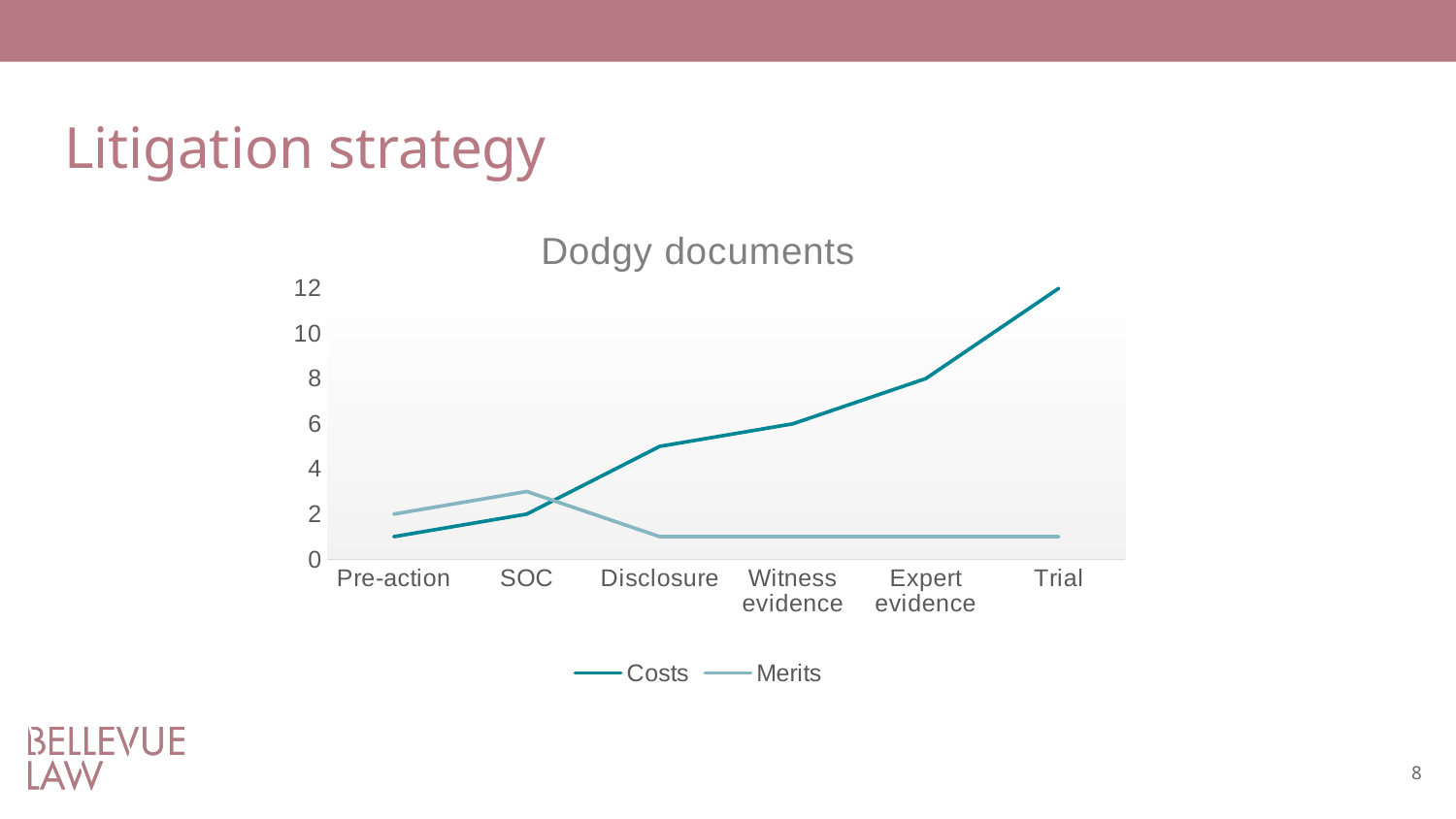
What kind of chart is shown on the slide? Line chart How many series does the legend list? 2 At which stage is the Costs series lowest? Pre-action Is the value of Costs at Disclosure greater or less than 4? greater What is the value of Merits at Pre-action? 2 What is the value of Costs at Trial? 12 At which stage is the Costs series highest? Trial What is the value of Costs at Expert evidence? 8 What is the title of the chart? Dodgy documents How many categories are shown on the x axis? 6 Does the Costs series rise or fall from Pre-action to Trial? Rise Which is larger at Trial, Costs or Merits? Costs